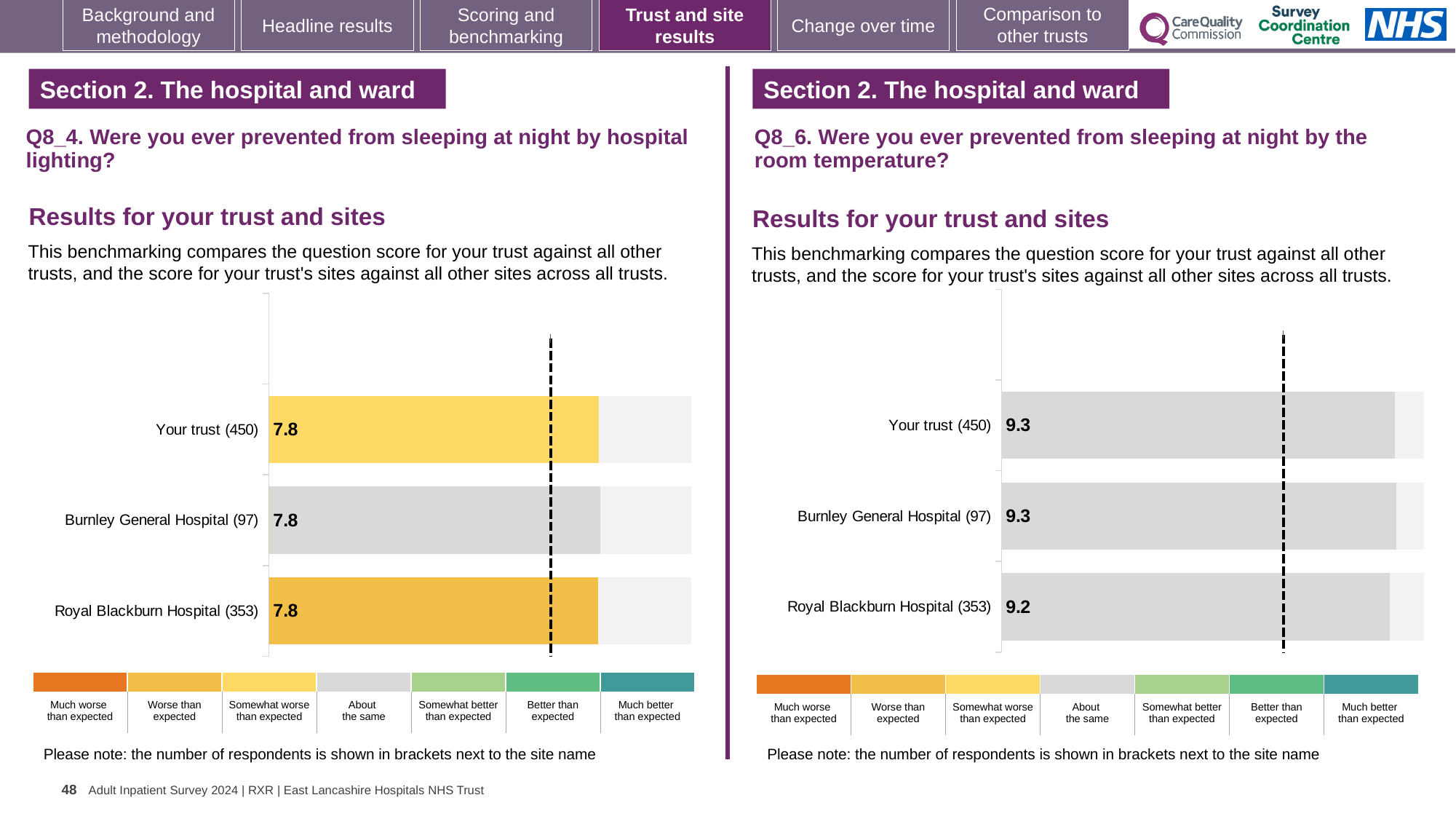
How many benchmark categories does the colour key below the Q8_4 chart list? 7 In the Q8_6 chart (room temperature), what is the difference between the score for Your trust (450) and Royal Blackburn Hospital (353)? 0.1 In the Q8_4 chart (hospital lighting), which benchmark category does the colour of the Royal Blackburn Hospital (353) bar correspond to? Worse than expected What kind of chart is used for the Q8_6 results (room temperature)? Bar chart In the Q8_6 chart (room temperature), what is the score for Royal Blackburn Hospital (353)? 9.2 In the Q8_6 chart (room temperature), what is the score for Your trust (450)? 9.3 In the Q8_6 chart (room temperature), which has the higher score, Burnley General Hospital (97) or Royal Blackburn Hospital (353)? Burnley General Hospital (97) How many bars are plotted in the Q8_4 chart (hospital lighting)? 3 In the Q8_6 chart (room temperature), which site has the lowest score? Royal Blackburn Hospital (353) In the Q8_4 chart (hospital lighting), what is the score for Royal Blackburn Hospital (353)? 7.8 In the Q8_4 chart (hospital lighting), what is the score for Your trust (450)? 7.8 In the Q8_6 chart (room temperature), what is the score for Burnley General Hospital (97)? 9.3